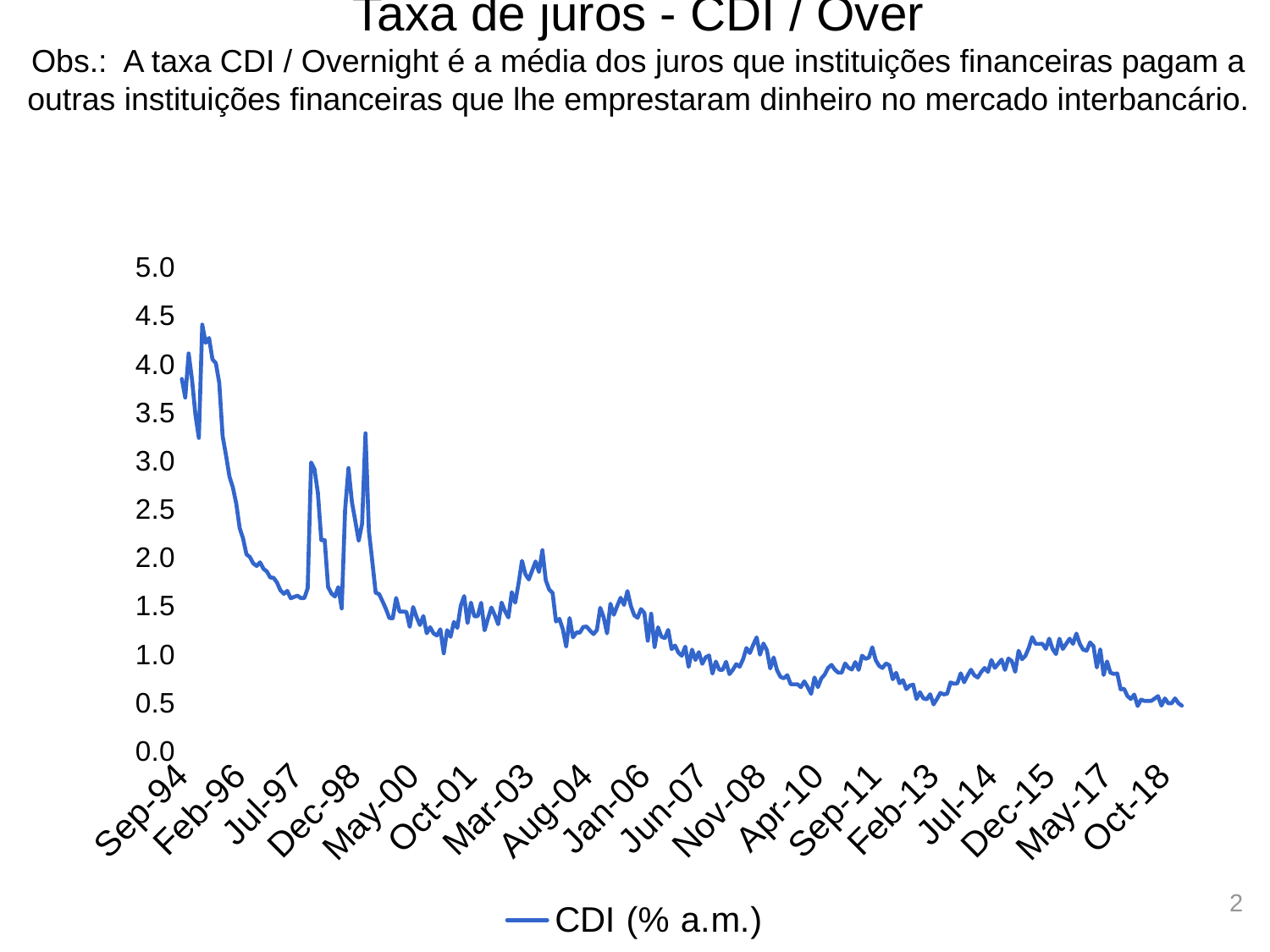
Overall, does the CDI rate rise or fall from Sep-94 to Oct-18? fall Is the value for Oct-18 greater or less than 1.0? less What is the title of the chart? Taxa de juros - CDI / Over Is the value for Jul-97 greater or less than 2.0? less What kind of chart is shown on the slide? line chart Is the value for Mar-03 greater or less than 1.5? greater How many series does the legend list? 1 How many date labels are shown on the x axis? 18 What is the name of the series shown in the legend? CDI (% a.m.)